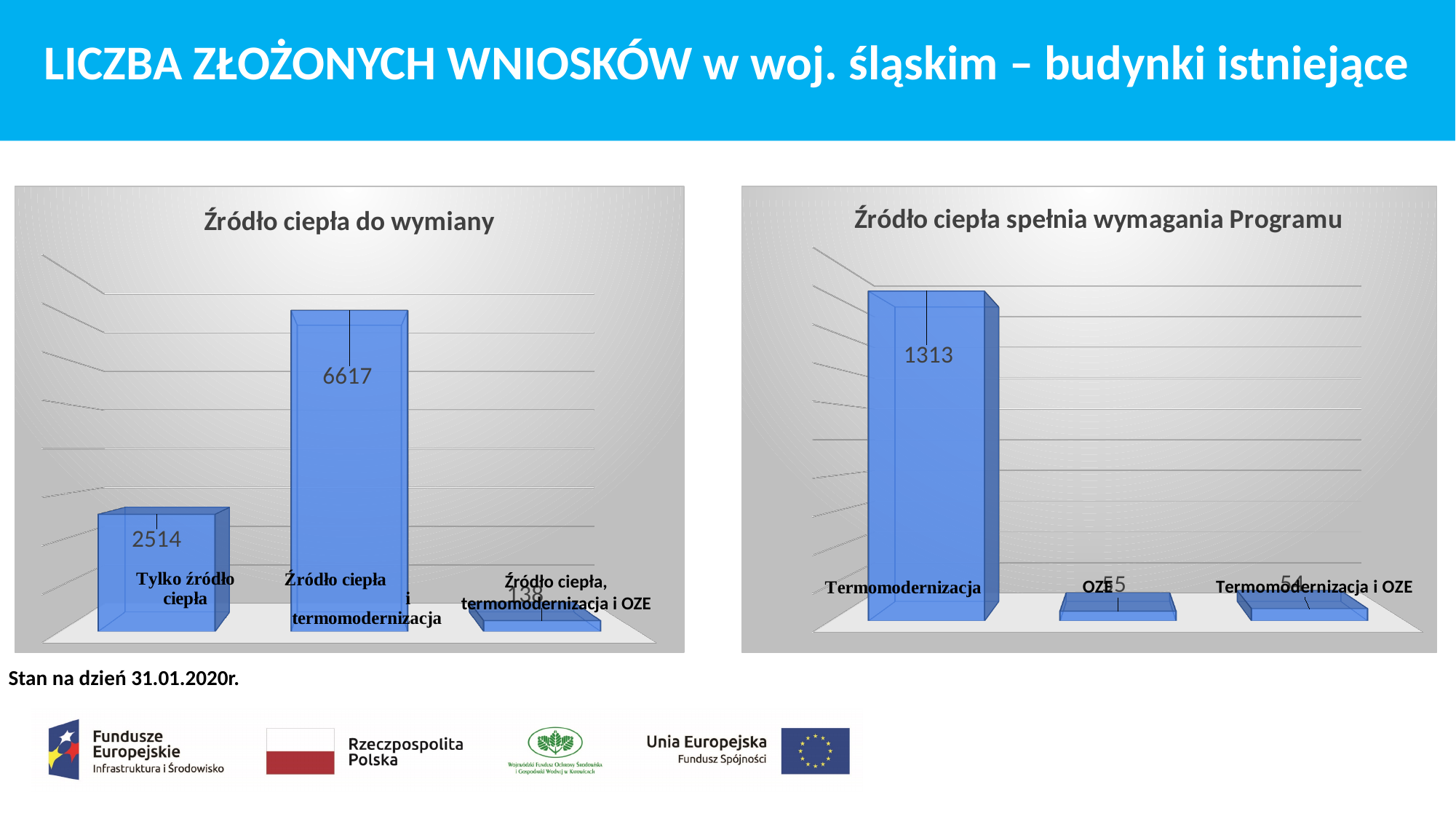
In the chart titled "Źródło ciepła do wymiany", which category has the lowest value? Źródło ciepła, termomodernizacja i OZE In the chart titled "Źródło ciepła do wymiany", what is the value for "Tylko źródło ciepła"? 2514 In the chart titled "Źródło ciepła spełnia wymagania Programu", which category has the highest value? Termomodernizacja In the chart titled "Źródło ciepła do wymiany", how many categories are shown? 3 In the chart titled "Źródło ciepła do wymiany", which category has the highest value? Źródło ciepła i termomodernizacja What is the title of the chart on the left of the slide? Źródło ciepła do wymiany In the chart titled "Źródło ciepła spełnia wymagania Programu", which is larger: the value for "Termomodernizacja" or the value for "OZE"? Termomodernizacja What kind of chart is the chart on the right of the slide? Bar chart In the chart titled "Źródło ciepła spełnia wymagania Programu", what is the value for "Termomodernizacja"? 1313 In the chart titled "Źródło ciepła do wymiany", what is the value for "Źródło ciepła i termomodernizacja"? 6617 In the chart titled "Źródło ciepła spełnia wymagania Programu", how many categories are shown? 3 In the chart titled "Źródło ciepła do wymiany", what is the difference between the values for "Źródło ciepła i termomodernizacja" and "Tylko źródło ciepła"? 4103